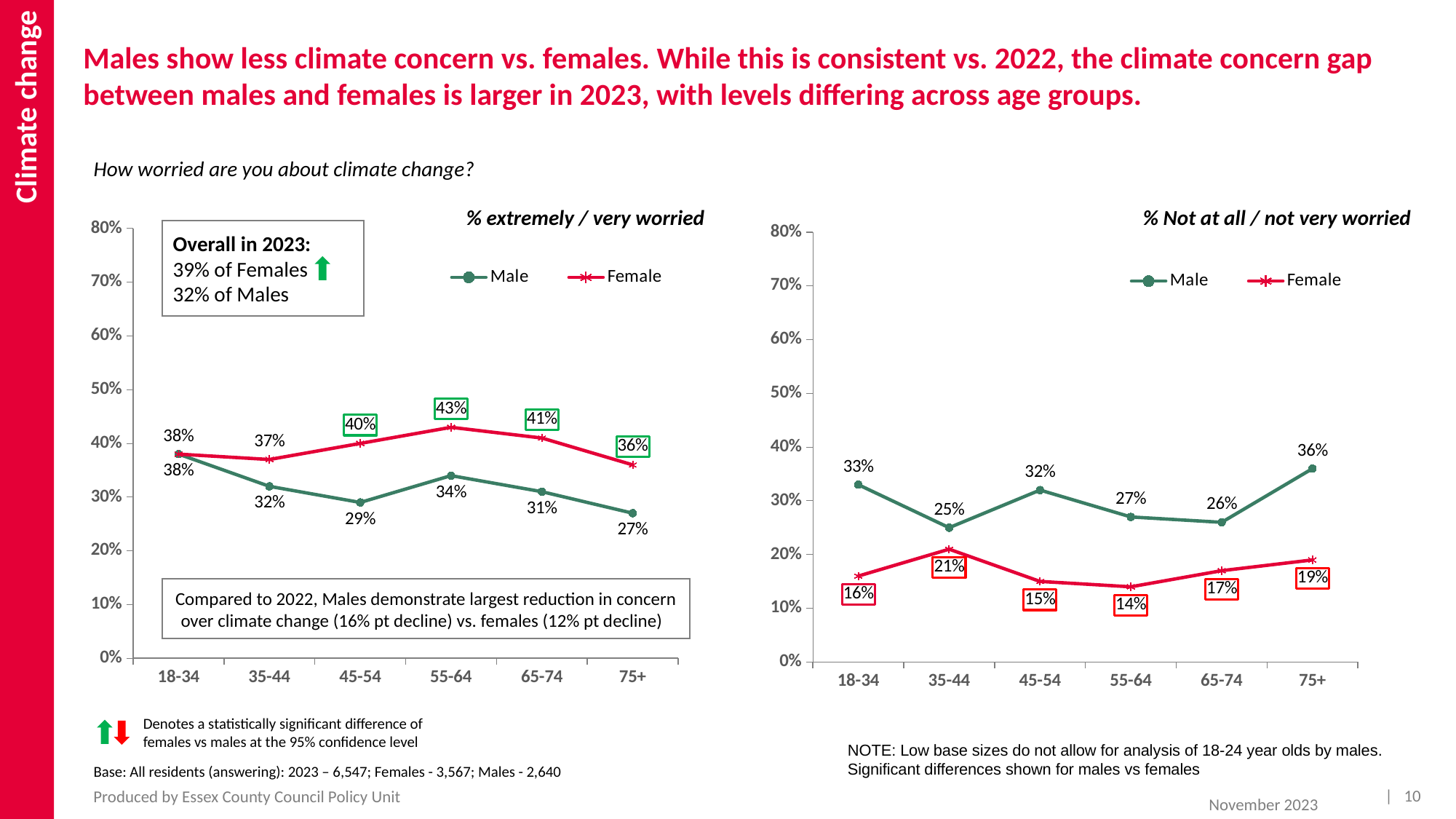
In the '% Not at all / not very worried' chart, what is the value for Males in the 75+ age group? 36% In the '% extremely / very worried' chart, which age group has the lowest value for Males? 75+ How many age groups are shown on the x axis of the '% Not at all / not very worried' chart? 6 In the '% Not at all / not very worried' chart, what is the difference between the Male and Female values for the 35-44 age group? 4% In the '% extremely / very worried' chart, what is the value for Males in the 45-54 age group? 29% In the '% extremely / very worried' chart, what is the value for Females in the 55-64 age group? 43% In the '% extremely / very worried' chart, what type of chart is shown? Line chart In the '% Not at all / not very worried' chart, what is the value for Females in the 55-64 age group? 14% In the '% Not at all / not very worried' chart, which age group has the highest value for Males? 75+ In the '% extremely / very worried' chart, what is the difference between the Female and Male values for the 75+ age group? 9% How many series does the legend of the '% extremely / very worried' chart list? 2 In the '% Not at all / not very worried' chart, which is larger for the 18-34 age group, the Male value or the Female value? Male